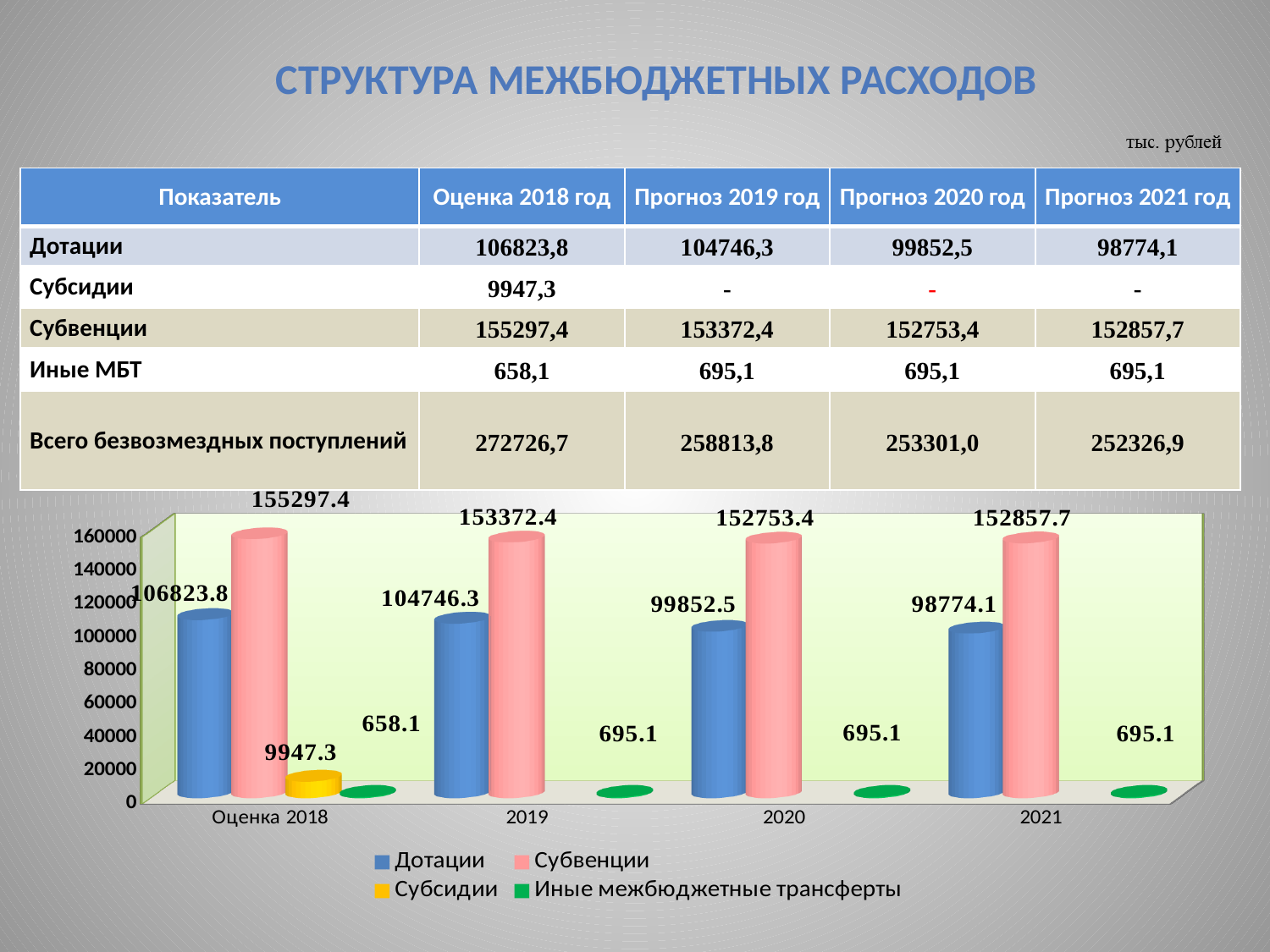
What type of chart is shown on the slide? bar chart What is the value of Дотации for 2020 in the chart? 99852.5 What is the value of Иные межбюджетные трансферты for 2021 in the chart? 695.1 What is the value of Субвенции for Оценка 2018 in the chart? 155297.4 Does the value of Дотации rise or fall from Оценка 2018 to 2021 in the chart? fall In which category is Дотации lowest in the chart? 2021 Which is larger in the chart for 2021: Дотации or Субвенции? Субвенции How many categories are shown on the x axis of the chart? 4 In which category is Дотации highest in the chart? Оценка 2018 How many series does the chart legend list? 4 What is the difference between Субвенции and Дотации for 2019 in the chart? 48626.1 What is the value of Субсидии for Оценка 2018 in the chart? 9947.3